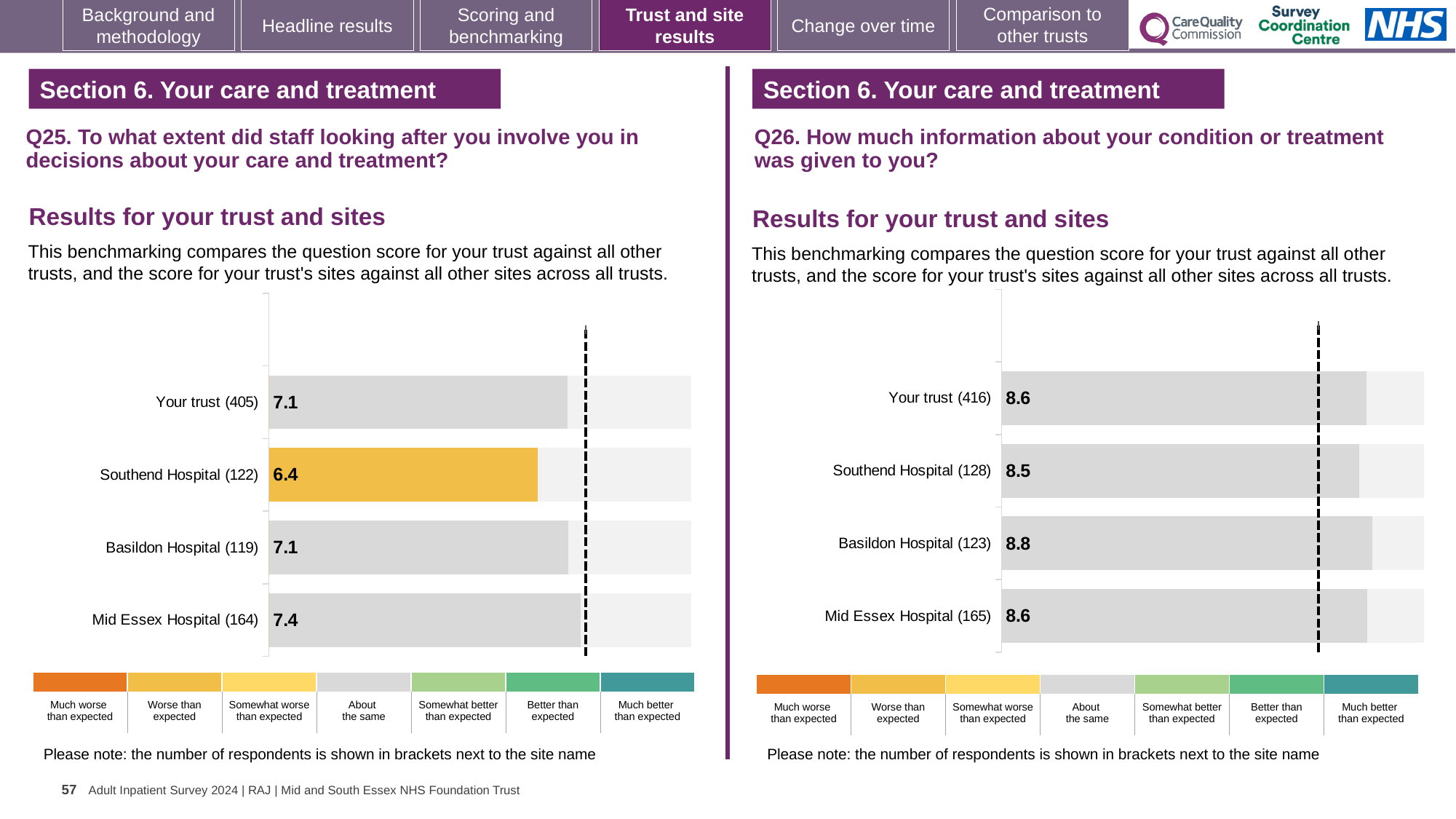
In the Q26 chart on the right, what is the score for Basildon Hospital? 8.8 How many bars are shown in the Q26 chart on the right? 4 In the Q26 chart on the right, which site has the highest score? Basildon Hospital In the Q25 chart on the left, which site's bar is coloured yellow rather than grey? Southend Hospital In the Q25 chart on the left, what is the difference between the scores for Mid Essex Hospital and Southend Hospital? 1.0 In the Q26 chart on the right, what is the score for Your trust? 8.6 In the Q25 chart on the left, which site has the lowest score? Southend Hospital In the Q25 chart on the left, what is the score for Mid Essex Hospital? 7.4 In the Q26 chart on the right, what is the difference between the scores for Basildon Hospital and Southend Hospital? 0.3 What type of chart is used for the Q25 results on the left? Bar chart In the Q25 chart on the left, which has the higher score, Basildon Hospital or Mid Essex Hospital? Mid Essex Hospital In the Q25 chart on the left, what is the score for Southend Hospital? 6.4